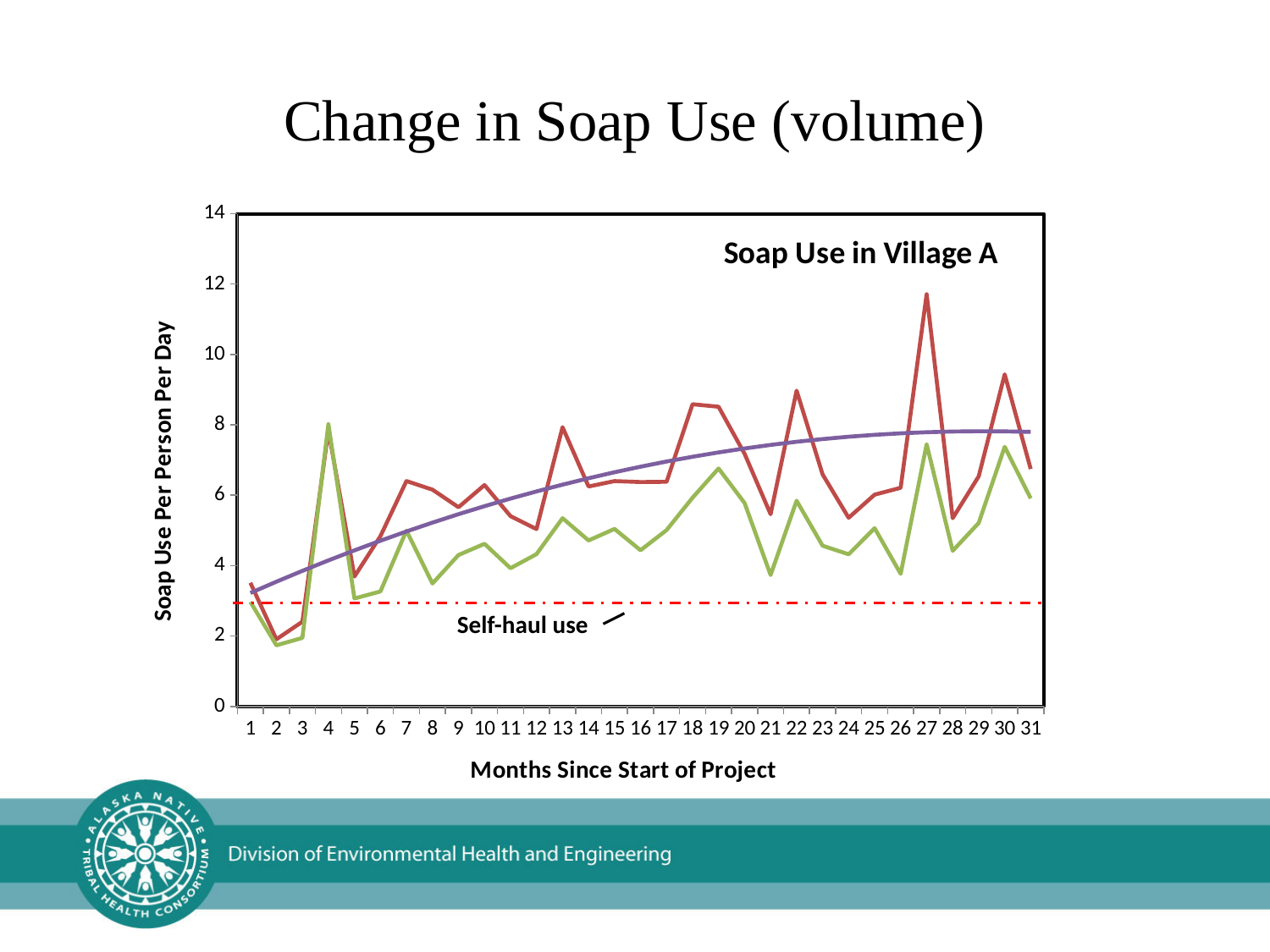
How many months are plotted along the x axis? 31 Is the value of the red line at month 22 greater or less than 8? greater What is the label of the y axis? Soap Use Per Person Per Day What kind of chart is shown on the slide? line chart Is the value of the green line at month 2 greater or less than 2? less Which is larger for the red line: the value at month 27 or the value at month 13? month 27 What is the title printed inside the chart area? Soap Use in Village A Is the dashed 'Self-haul use' line greater or less than 4? less Does the purple trend line rise or fall as months increase? rise Which is larger for the green line: the value at month 19 or the value at month 21? month 19 At which month does the red line reach its highest value? 27